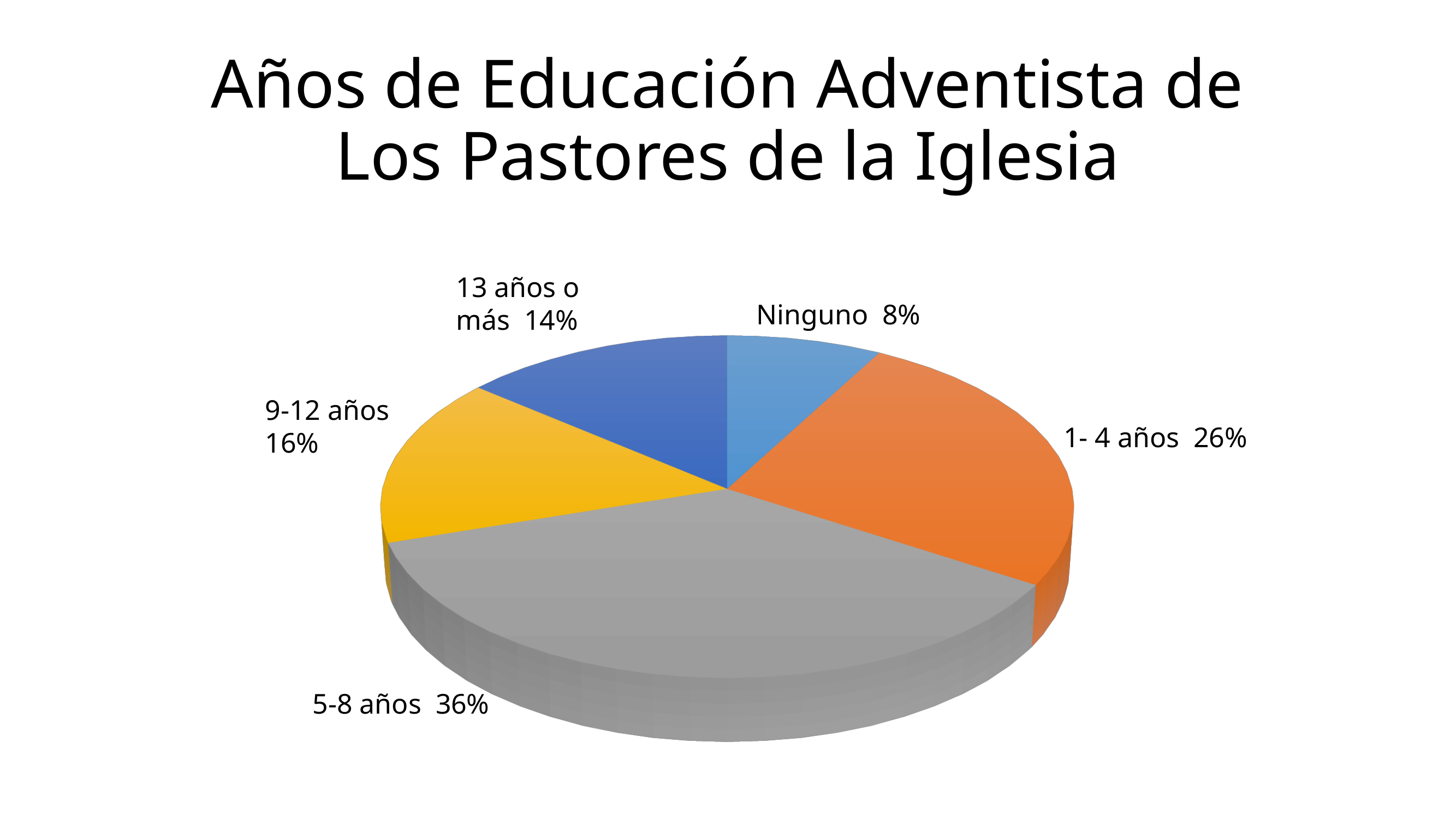
What is the difference in percentage points between "5-8 años" and "1- 4 años"? 10 Which category has the smallest slice of the pie? Ninguno What percentage is shown for "Ninguno"? 8% What percentage is shown for "13 años o más"? 14% What percentage is shown for "9-12 años"? 16% What share of the pie does the "5-8 años" slice represent? 36% Which category has the largest slice of the pie? 5-8 años How many categories are shown in the pie chart? 5 Which is larger, the share for "9-12 años" or the share for "13 años o más"? 9-12 años What kind of chart is shown on the slide? Pie chart What percentage is shown for "1- 4 años"? 26% What is the title of the chart? Años de Educación Adventista de Los Pastores de la Iglesia